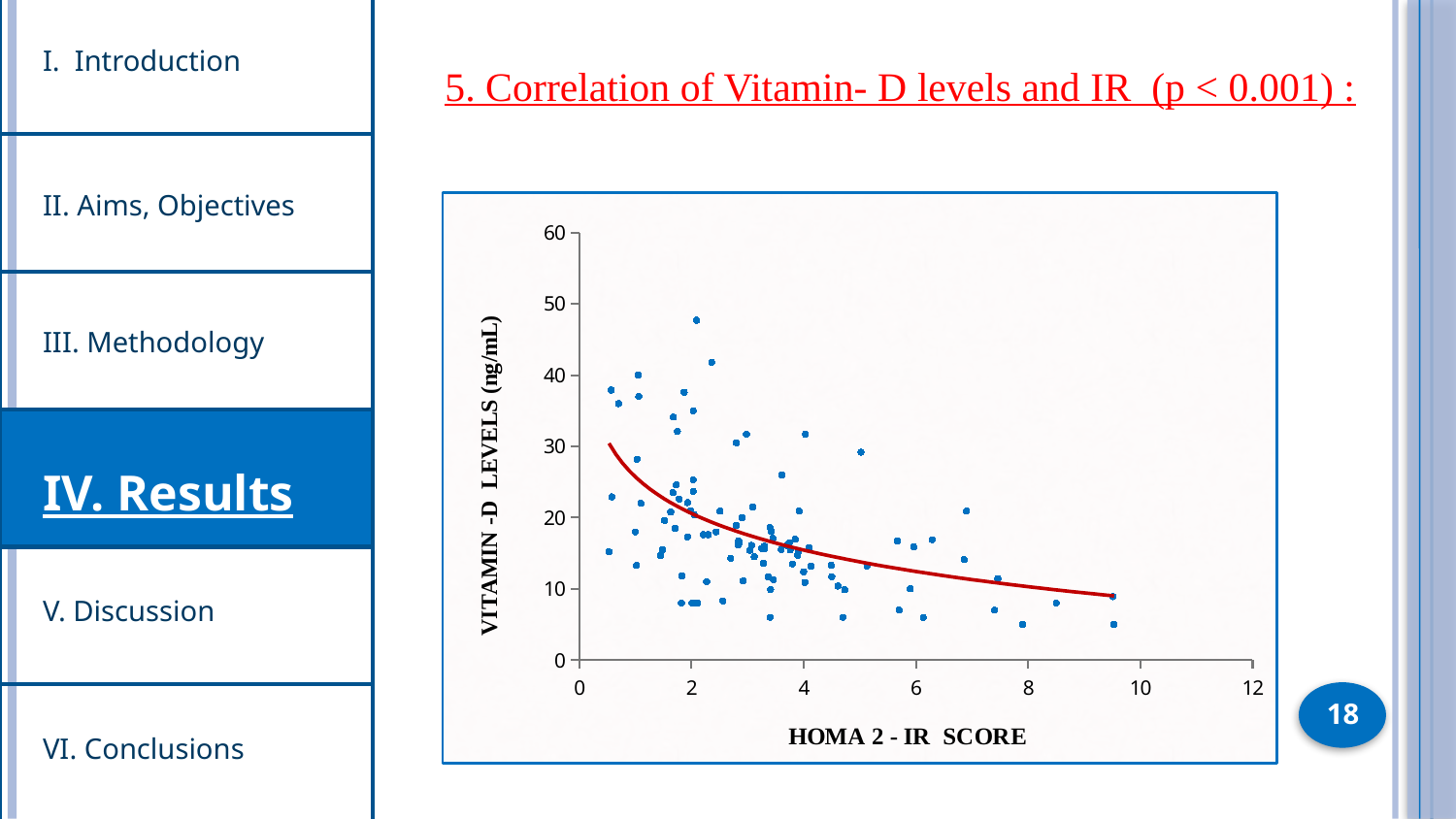
Is the fitted curve's value at a HOMA 2 - IR score of 1 greater or less than 20 ng/mL? greater Does the fitted red curve slope upward or downward as the HOMA 2 - IR score increases? downward What is the label of the x axis? HOMA 2 - IR SCORE What kind of chart is shown on the slide? scatter plot As the HOMA 2 - IR score increases along the x axis, do the vitamin D levels generally rise or fall? fall What is the label of the y axis? VITAMIN -D LEVELS (ng/mL) Is the fitted curve's value at a HOMA 2 - IR score of 6 greater or less than 20 ng/mL? less